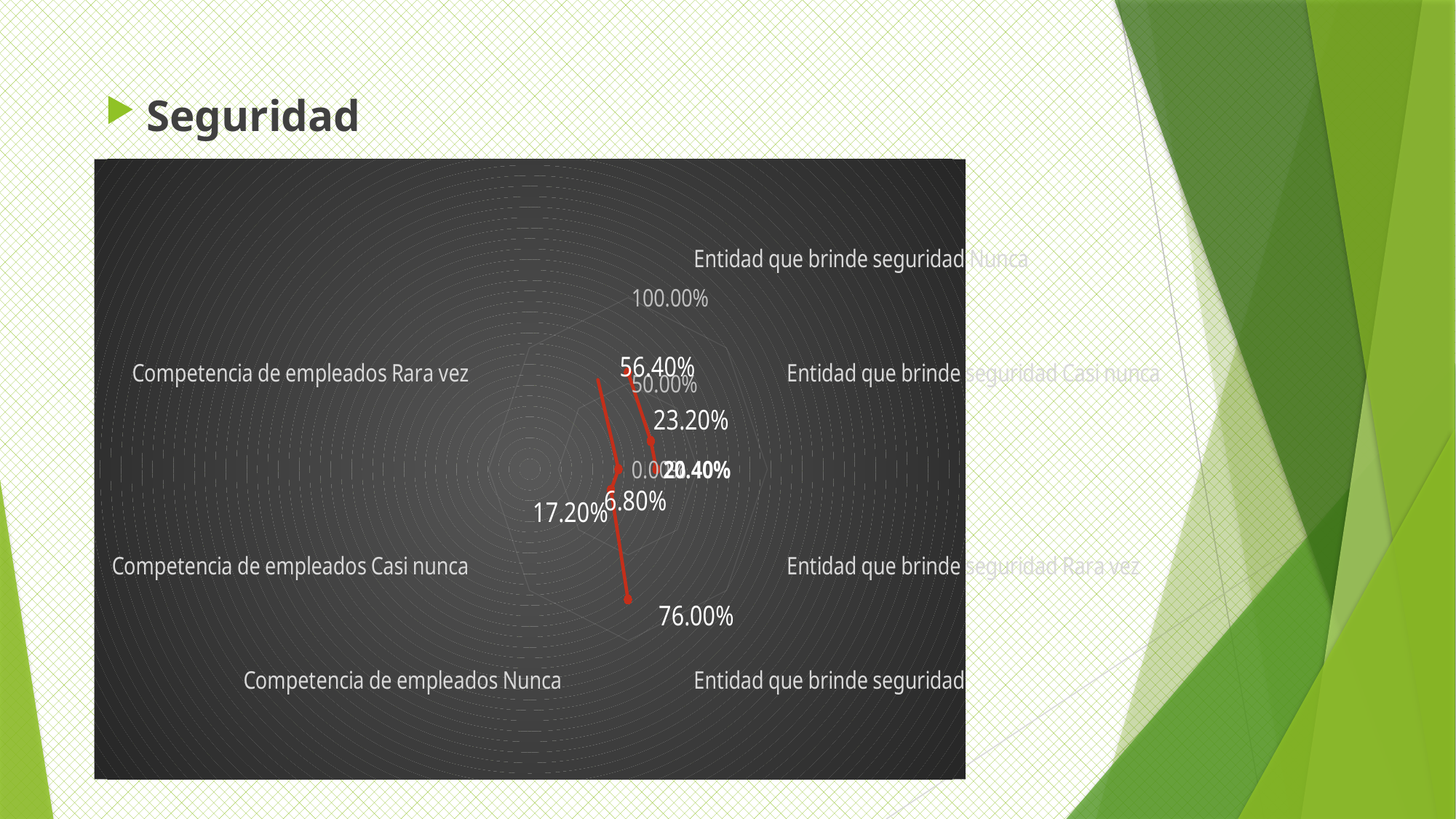
How many category axes does the radar chart have? 7 What is the title of the slide containing the chart? Seguridad What is the difference between the data labels 23.20% and 6.80%? 16.40% What is the difference between the data labels 76.00% and 56.40%? 19.60% Which is larger, the data label 56.40% or the data label 23.20%? 56.40% What is the maximum value shown on the chart's axis scale? 100.00% What is the highest data label shown on the chart? 76.00% Is the value for Entidad que brinde seguridad Nunca greater or less than 50.00%? greater What kind of chart is shown on the slide? radar chart What is the value for Entidad que brinde seguridad Nunca? 56.40%